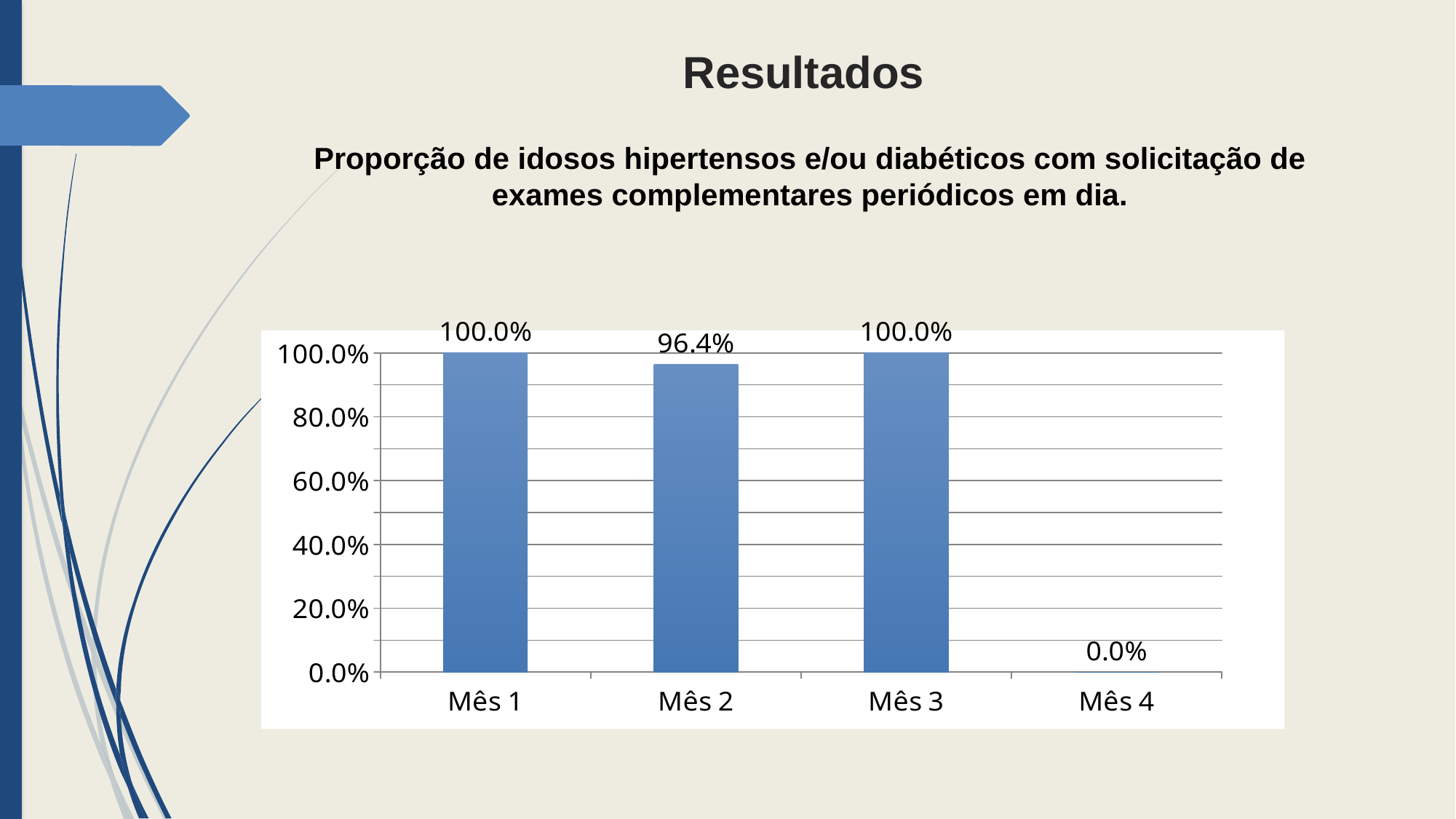
Is the value for Mês 2 greater or less than 80.0%? greater What is the difference between the values for Mês 1 and Mês 2? 3.6% What is the value for Mês 3? 100.0% What is the difference between the values for Mês 3 and Mês 4? 100.0% What is the highest value shown on the vertical axis? 100.0% Which is larger, the value for Mês 2 or the value for Mês 3? Mês 3 What is the value for Mês 4? 0.0% What is the value for Mês 1? 100.0% What kind of chart is shown on the slide? bar chart What is the value for Mês 2? 96.4% How many categories are shown on the x axis? 4 Which category has the lowest value? Mês 4